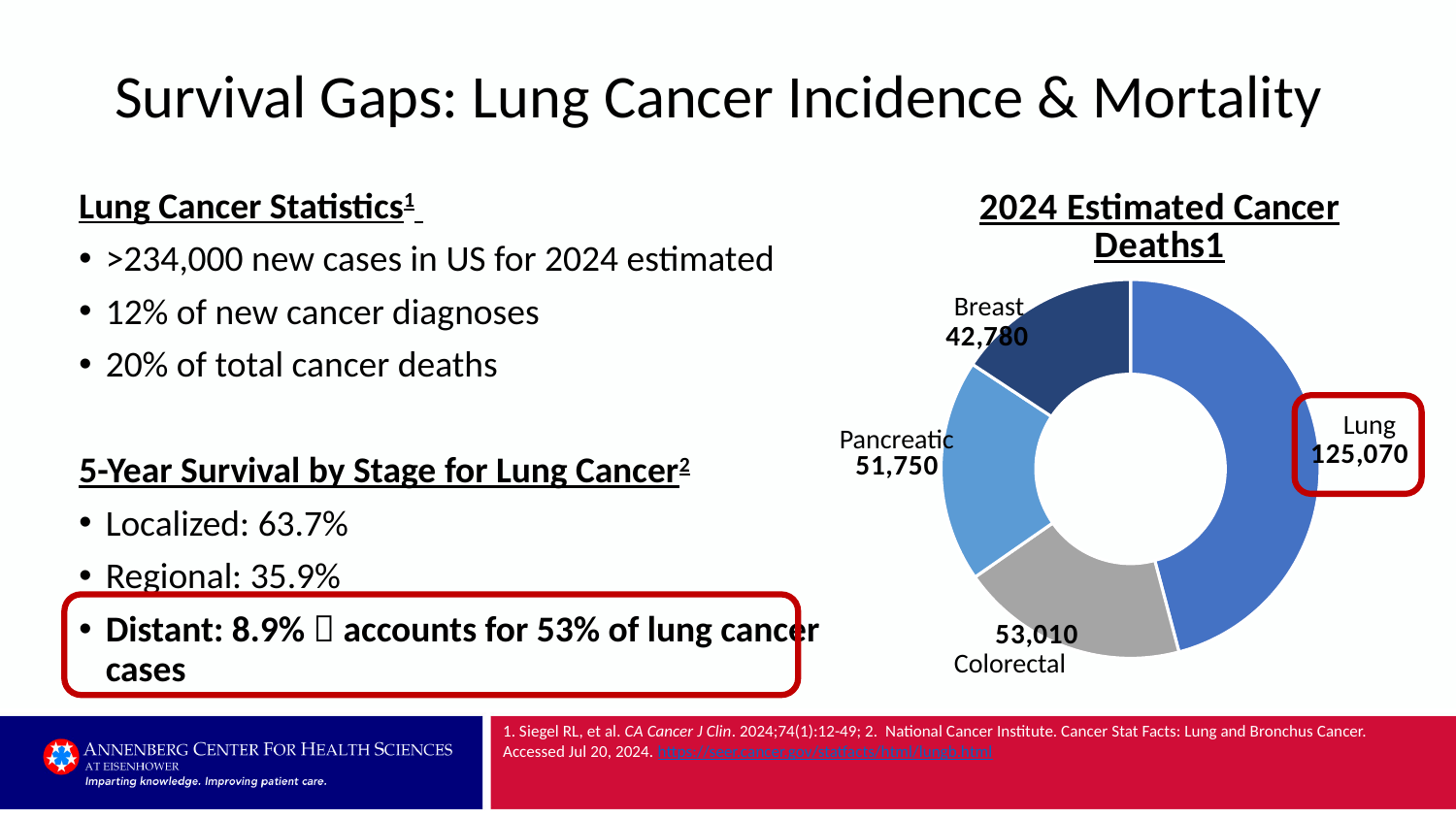
How many cancer types are shown in the chart? 4 Which slice of the chart is highlighted with a red outline? Lung What is the estimated number of deaths for Colorectal cancer in the chart? 53,010 What is the estimated number of deaths for Breast cancer in the chart? 42,780 Which has more estimated deaths in the chart, Colorectal or Pancreatic cancer? Colorectal Which cancer type has the lowest estimated deaths in the chart? Breast What is the title of the chart? 2024 Estimated Cancer Deaths1 What is the estimated number of deaths for Lung cancer in the chart? 125,070 Which cancer type has the highest estimated deaths in the chart? Lung What type of chart is shown on the slide? doughnut chart What is the difference between the estimated deaths for Lung and Colorectal cancer? 72,060 What is the estimated number of deaths for Pancreatic cancer in the chart? 51,750